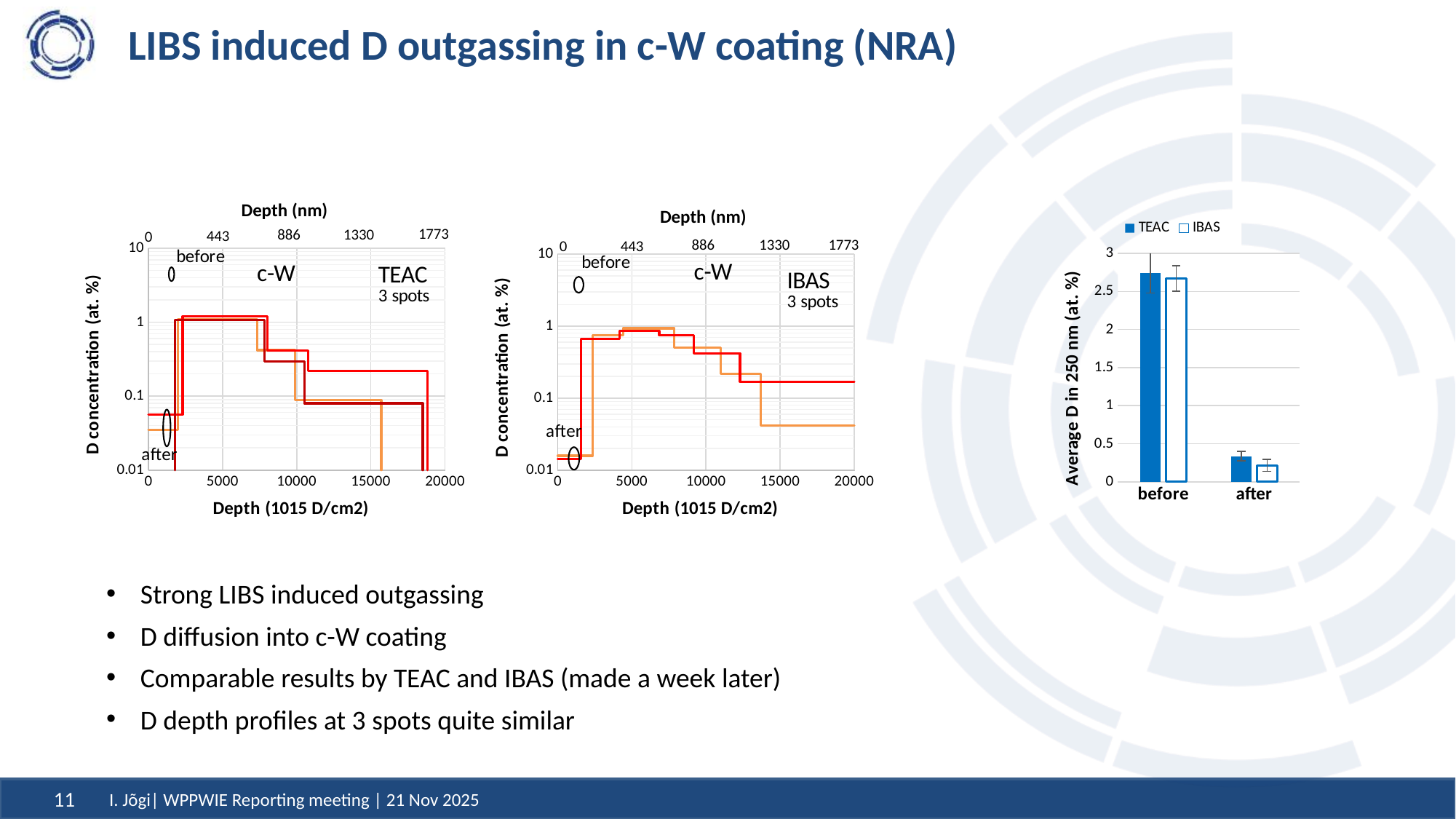
In the bar chart on the right, is the TEAC value for 'before' greater or less than 2.5? greater In the TEAC chart on the left, is the 'after' D concentration near a depth of 1000 greater or less than 0.1? less In the bar chart on the right, do the values fall or rise from 'before' to 'after'? fall What kind of chart is the chart on the right of the slide with the 'Average D in 250 nm (at. %)' axis? bar chart In the IBAS chart in the middle, is the 'after' D concentration near a depth of 1000 greater or less than 0.1? less In the bar chart on the right, how many series does the legend list? 2 In the bar chart on the right, what are the two series named in the legend? TEAC and IBAS In the bar chart on the right, which category has the higher TEAC value, 'before' or 'after'? before In the bar chart on the right, what is the label of the vertical axis? Average D in 250 nm (at. %) In the bar chart on the right, how many categories are shown on the x axis? 2